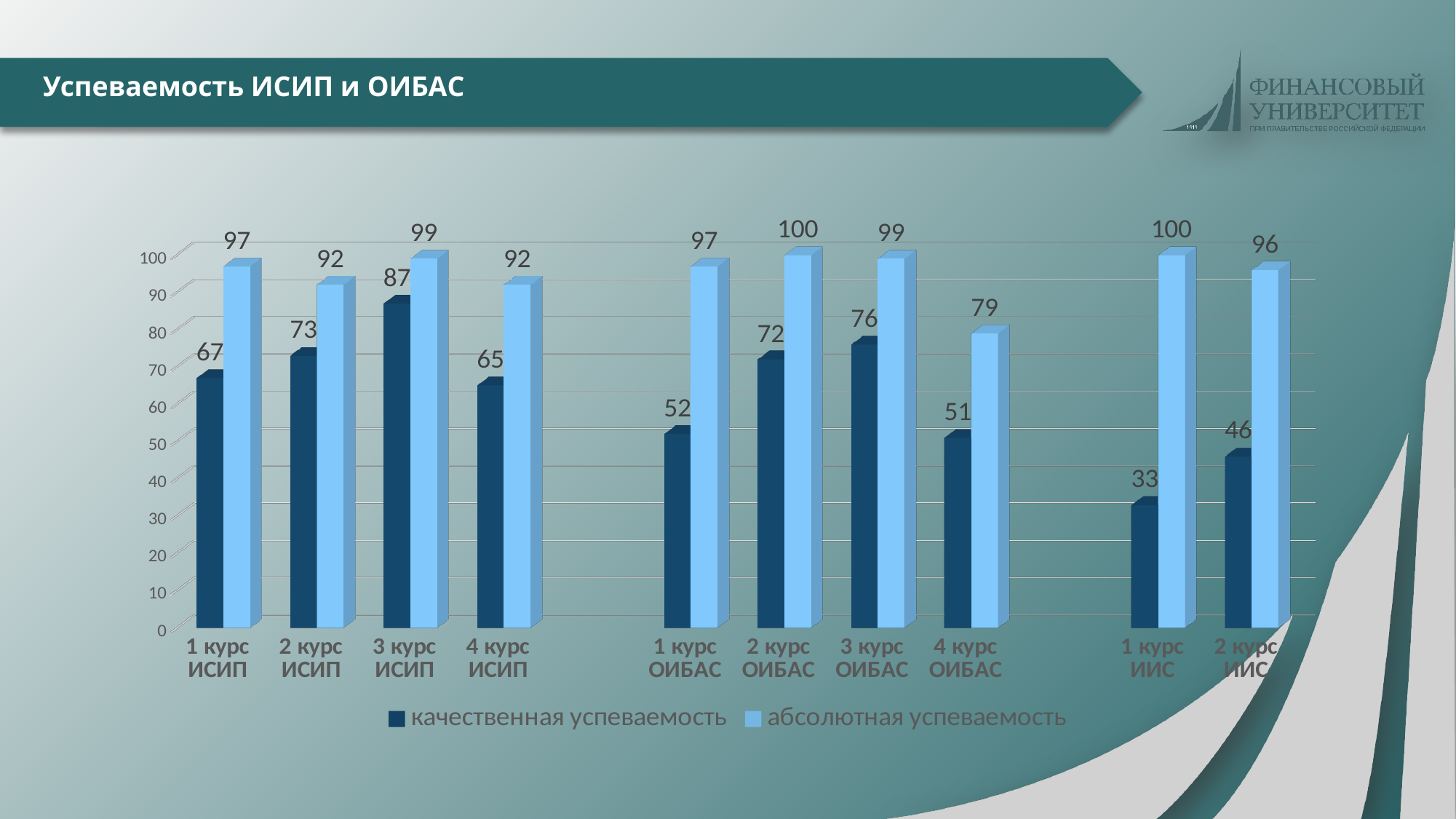
How many series does the legend list? 2 What is the value of качественная успеваемость for 1 курс ИИС? 33 Which category has the lowest качественная успеваемость? 1 курс ИИС What is the difference between абсолютная успеваемость and качественная успеваемость for 1 курс ОИБАС? 45 Which category has the lowest абсолютная успеваемость? 4 курс ОИБАС Which category has the highest качественная успеваемость? 3 курс ИСИП What kind of chart is shown on the slide? Bar chart How many categories are shown on the x axis? 10 What is the title of the slide? Успеваемость ИСИП и ОИБАС What is the value of абсолютная успеваемость for 4 курс ОИБАС? 79 What is the value of качественная успеваемость for 3 курс ИСИП? 87 Which is larger: качественная успеваемость for 2 курс ИСИП or for 2 курс ОИБАС? 2 курс ИСИП